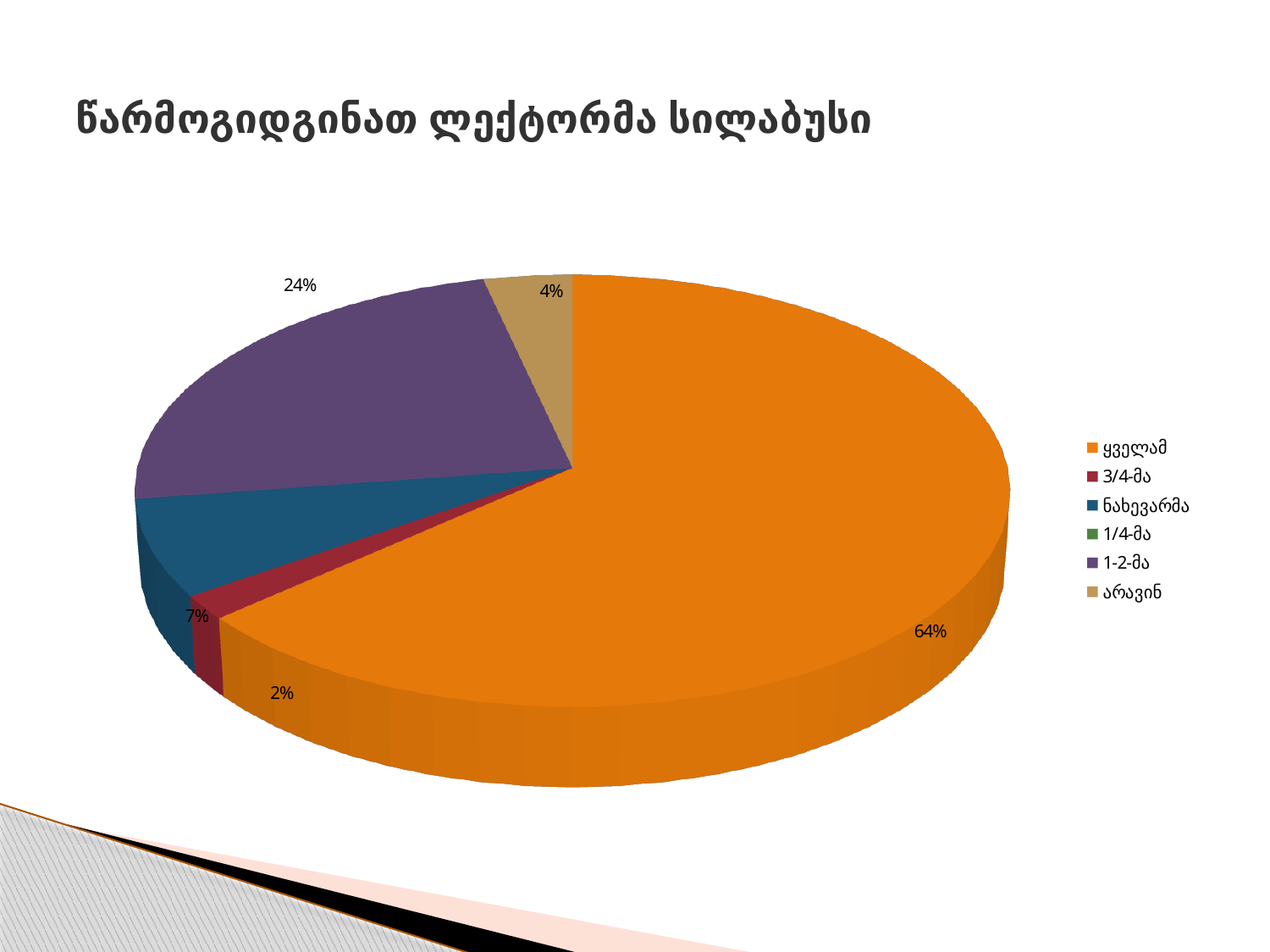
What is the title of the chart slide? წარმოგიდგინათ ლექტორმა სილაბუსი What percentage is shown for the ნახევარმა slice? 7% What kind of chart is shown on the slide? pie chart Which of the labelled slices is the smallest? 3/4-მა How many categories does the legend list? 6 What is the difference in percentage points between the ყველამ slice and the 1-2-მა slice? 40 percentage points What percentage of the pie is labelled for the ყველამ slice? 64% Which slice is larger, ნახევარმა or არავინ? ნახევარმა What percentage is shown for the 1-2-მა slice? 24% What percentage is shown for the არავინ slice? 4% Which category has the largest slice of the pie? ყველამ What percentage is shown for the 3/4-მა slice? 2%